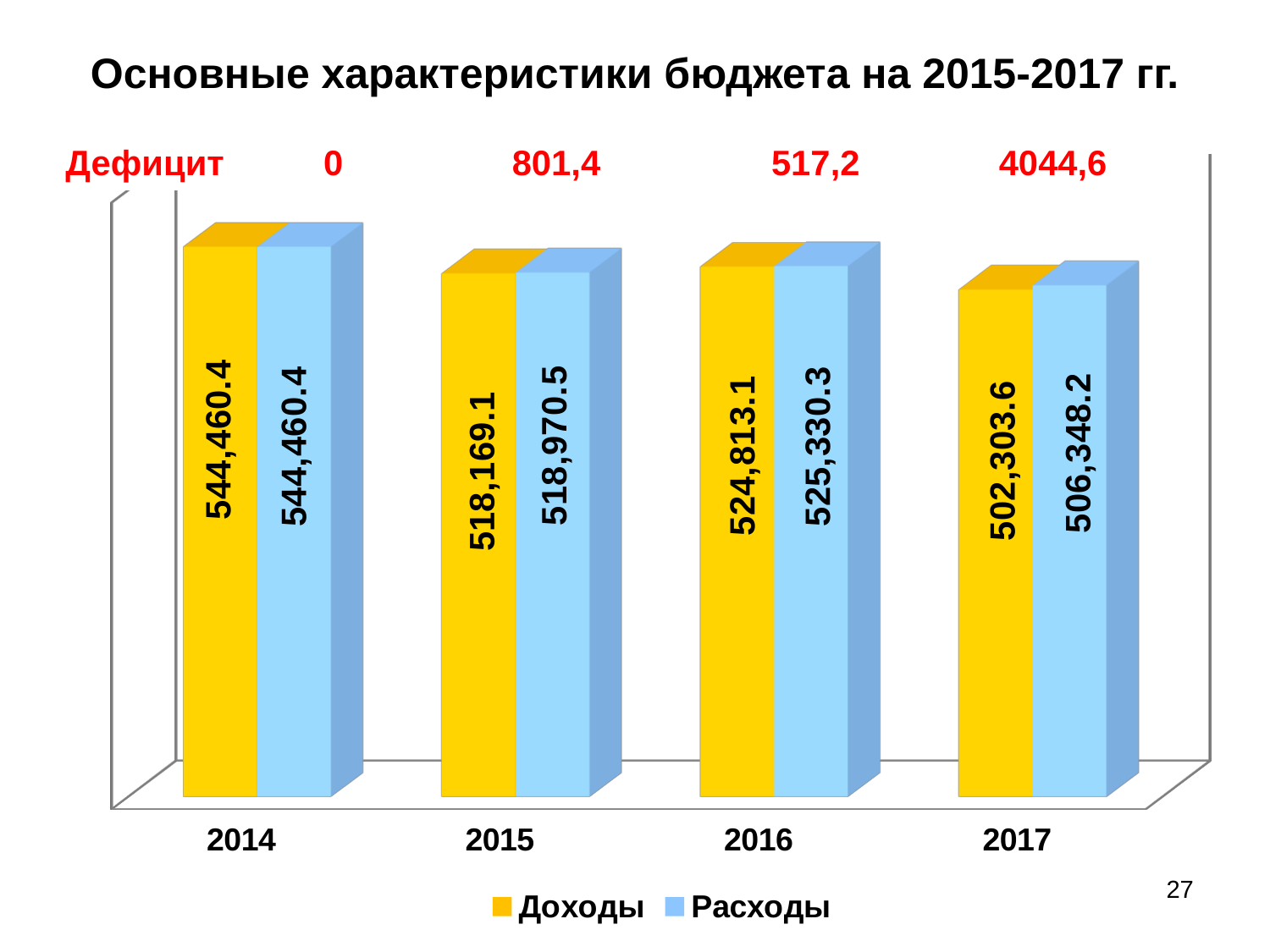
What is the difference between Расходы and Доходы in 2015? 801.4 What kind of chart is shown on the slide? Bar chart What is the value of Расходы for 2015? 518,970.5 What is the value of Доходы for 2016? 524,813.1 What is the value of Расходы for 2017? 506,348.2 In which year is Доходы the highest? 2014 How many years are shown on the x axis? 4 Which is larger in 2016, Доходы or Расходы? Расходы What is the difference between Расходы and Доходы in 2017? 4,044.6 In which year is Расходы the lowest? 2017 How many series does the legend list? 2 What is the value of Доходы for 2014? 544,460.4